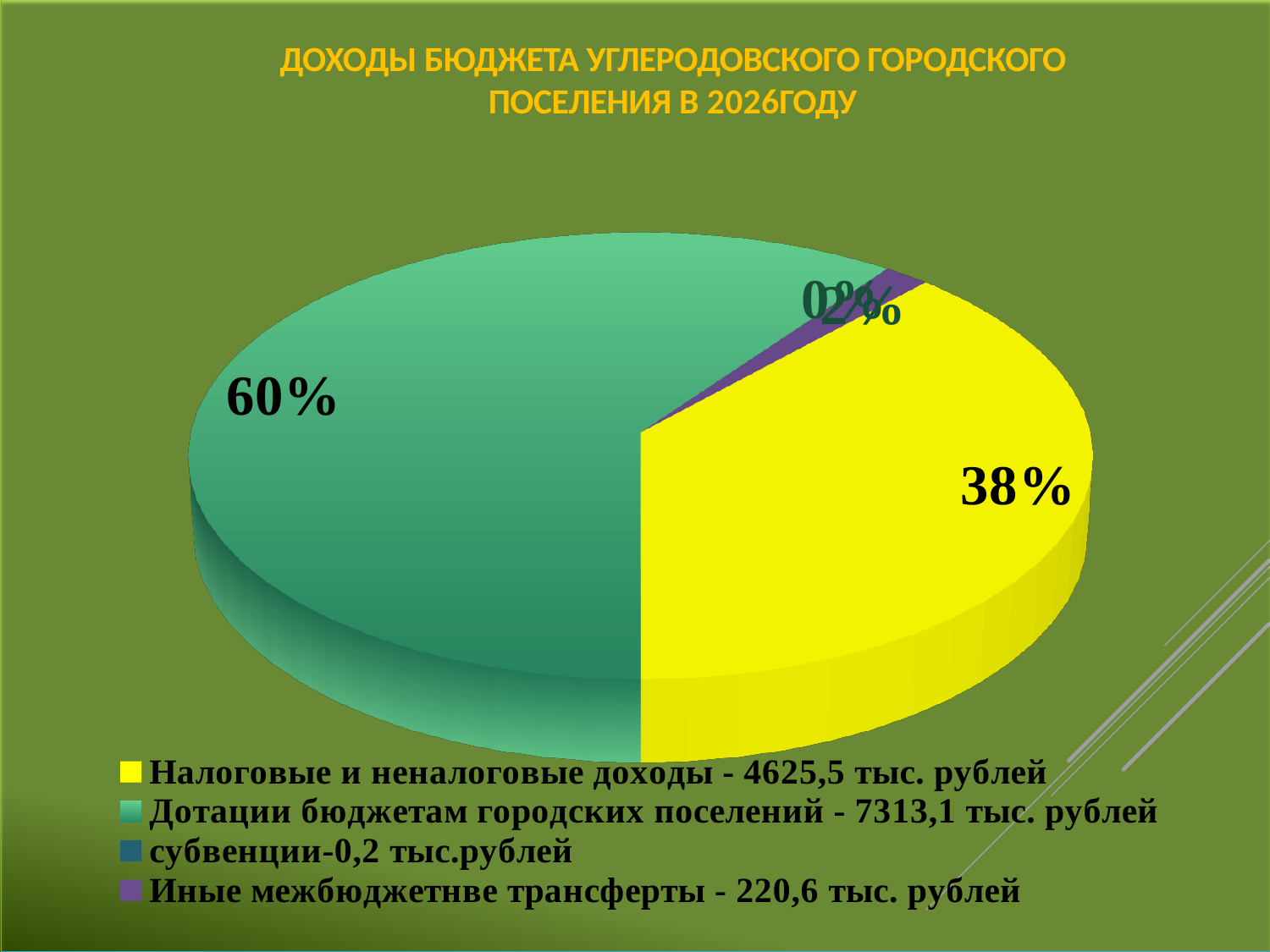
How many categories does the legend list? 4 According to the legend, what is the amount for "субвенции"? 0,2 тыс.рублей According to the legend, what is the amount for "Дотации бюджетам городских поселений"? 7313,1 тыс. рублей Which category has the largest slice of the pie? Дотации бюджетам городских поселений According to the legend, what is the amount for "Иные межбюджетнве трансферты"? 220,6 тыс. рублей What colour is the slice for "Налоговые и неналоговые доходы"? Yellow According to the legend, what is the amount for "Налоговые и неналоговые доходы"? 4625,5 тыс. рублей What kind of chart is shown on the slide? Pie chart What share of the pie does the slice for "Налоговые и неналоговые доходы" represent? 38% What is the difference in percentage points between the 60% slice and the 38% slice? 22 percentage points What share of the pie does the slice for "Дотации бюджетам городских поселений" represent? 60% Which is larger: the slice for "Дотации бюджетам городских поселений" or the slice for "Налоговые и неналоговые доходы"? Дотации бюджетам городских поселений